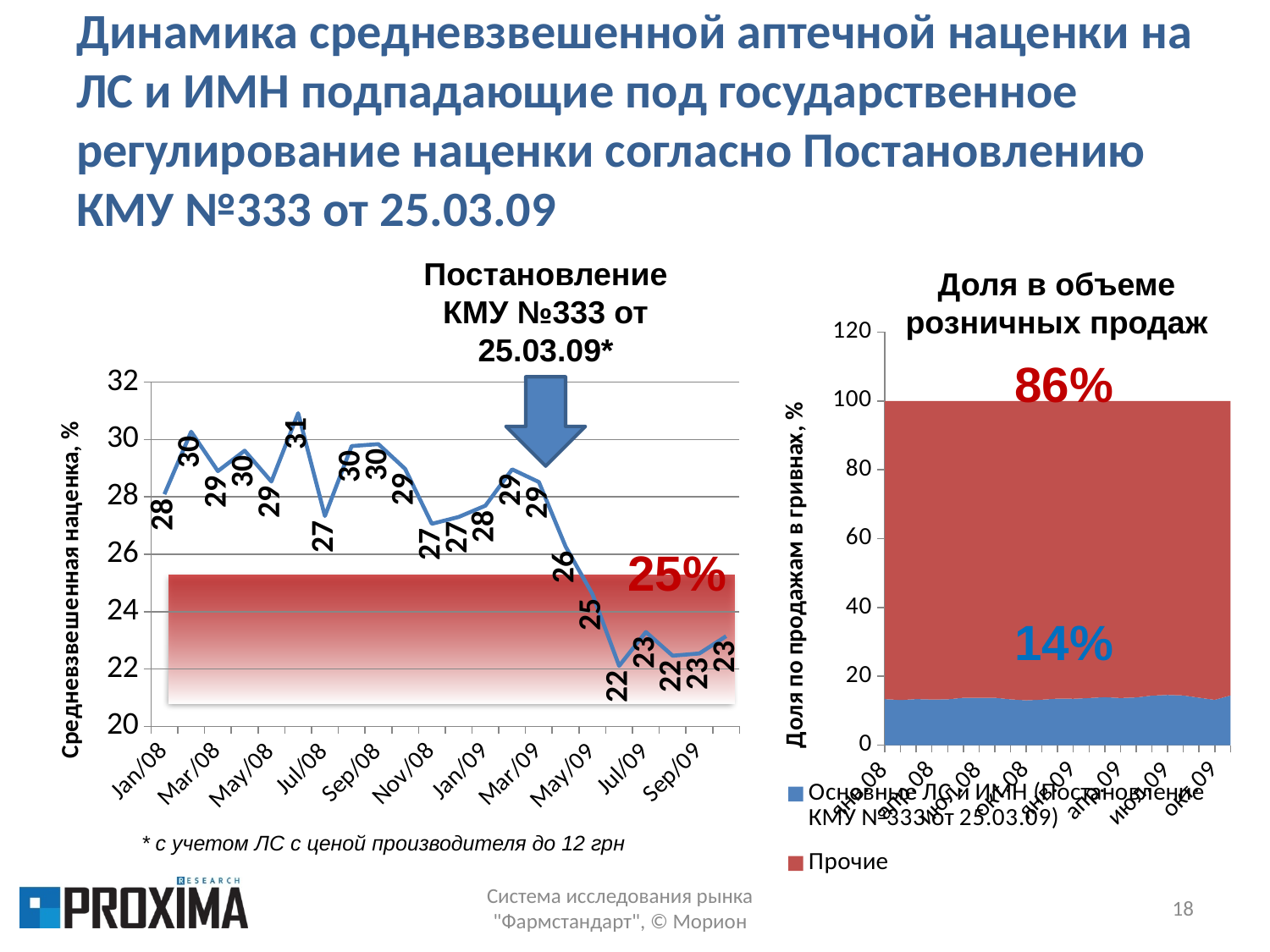
On the left line chart, what is the value for Jul/09? 23 What kind of chart is the left chart? line chart On the left line chart, what is the highest data label shown? 31 On the left line chart, what is the difference between the values for Jan/09 and Jul/09? 5 How many series does the legend of the right chart 'Доля в объеме розничных продаж' list? 2 On the left line chart, what is the value for May/09? 25 On the left line chart, what is the lowest data label shown? 22 On the left line chart, what is the value for Sep/08? 30 On the left line chart, which is larger: the value for Mar/09 or the value for Sep/09? Mar/09 On the right chart 'Доля в объеме розничных продаж', what share is labelled for 'Прочие'? 86% On the left line chart, what is the weighted average markup value for Jan/08? 28 On the left line chart, do the values overall rise or fall from Jan/08 to Sep/09? fall